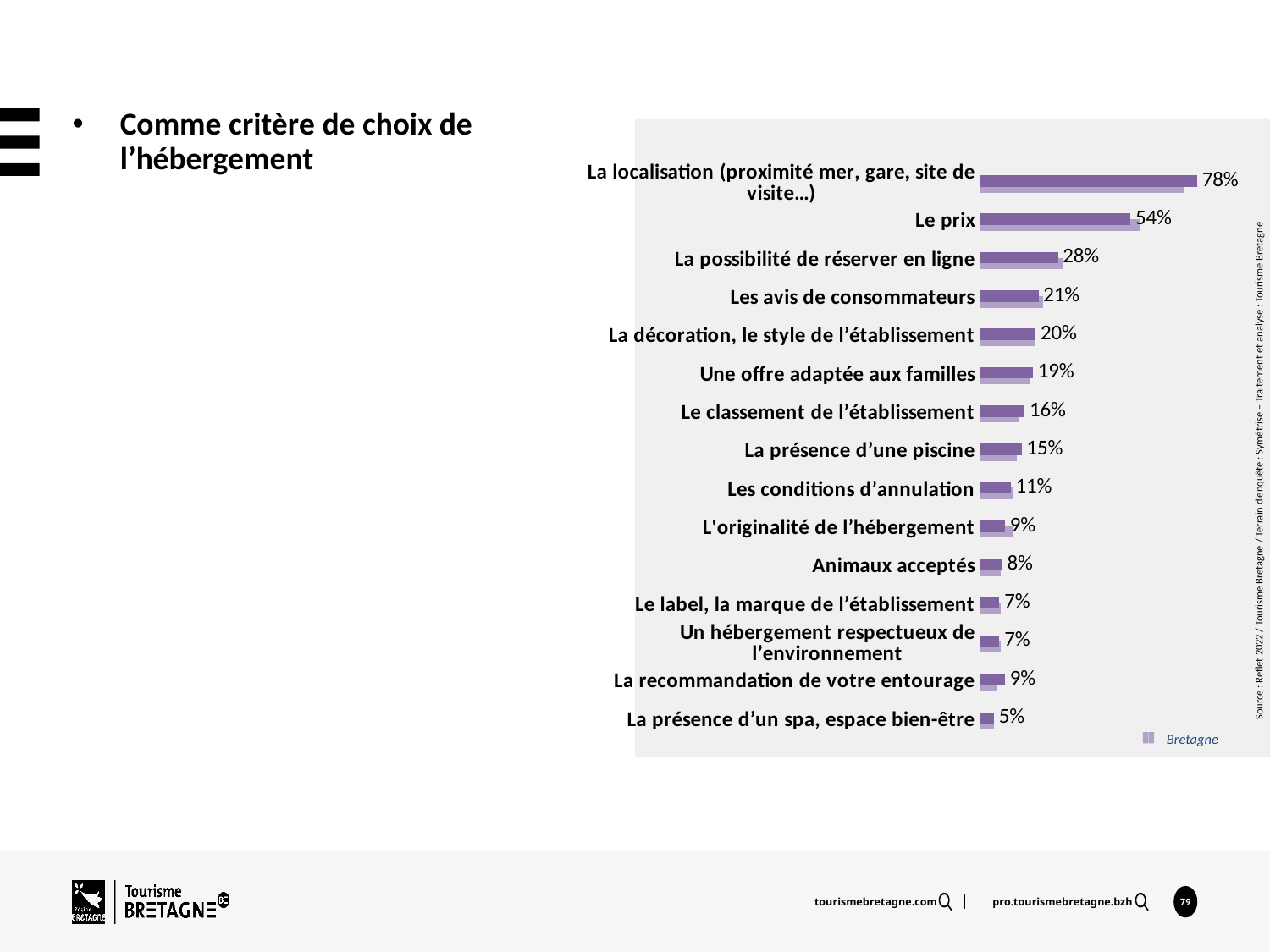
Which category has the lowest value? La présence d'un spa, espace bien-être How many categories are shown in the chart? 15 What is the value for "La possibilité de réserver en ligne"? 28% What kind of chart is shown on the slide? Bar chart Which is larger, the value for "Les avis de consommateurs" or the value for "Une offre adaptée aux familles"? Les avis de consommateurs What is the value for "Animaux acceptés"? 8% What is the difference between the values for "La localisation (proximité mer, gare, site de visite…)" and "Le prix"? 24% What is the value for "La présence d'une piscine"? 15% What is the value for "Le prix"? 54% What entry does the chart legend list? Bretagne Which category has the highest value? La localisation (proximité mer, gare, site de visite…) What is the difference between the values for "Les conditions d'annulation" and "L'originalité de l'hébergement"? 2%